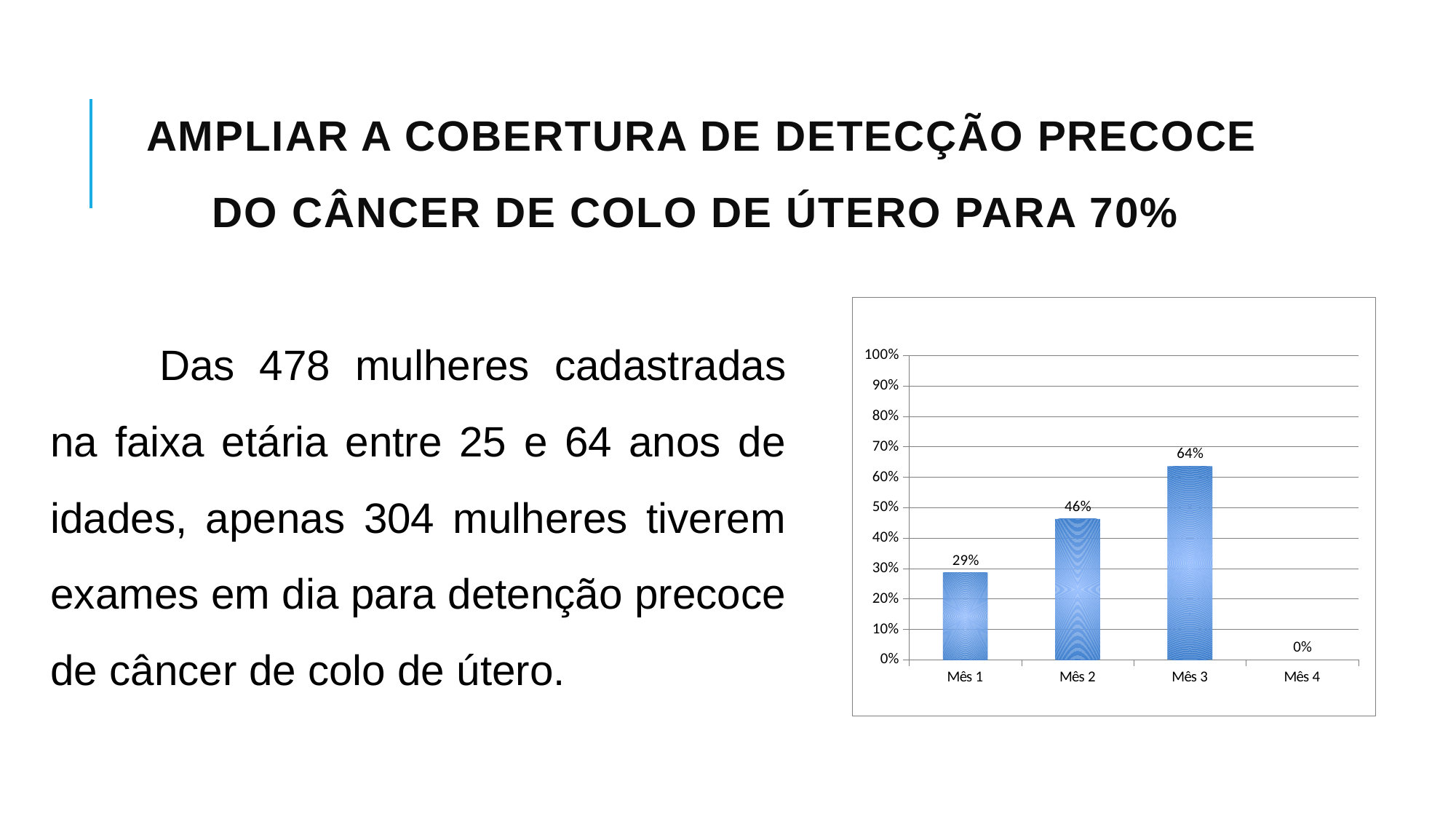
What is the value for Mês 4? 0% Is the value for Mês 3 greater or less than 70%? less What is the value for Mês 3? 64% What is the difference between the values for Mês 2 and Mês 1? 17% What is the value for Mês 2? 46% What kind of chart is shown on the slide? bar chart What is the difference between the values for Mês 3 and Mês 1? 35% Which category has the highest value? Mês 3 What is the value for Mês 1? 29% Which category has the lowest value? Mês 4 Which is larger, the value for Mês 2 or the value for Mês 3? Mês 3 How many categories are shown on the x axis? 4